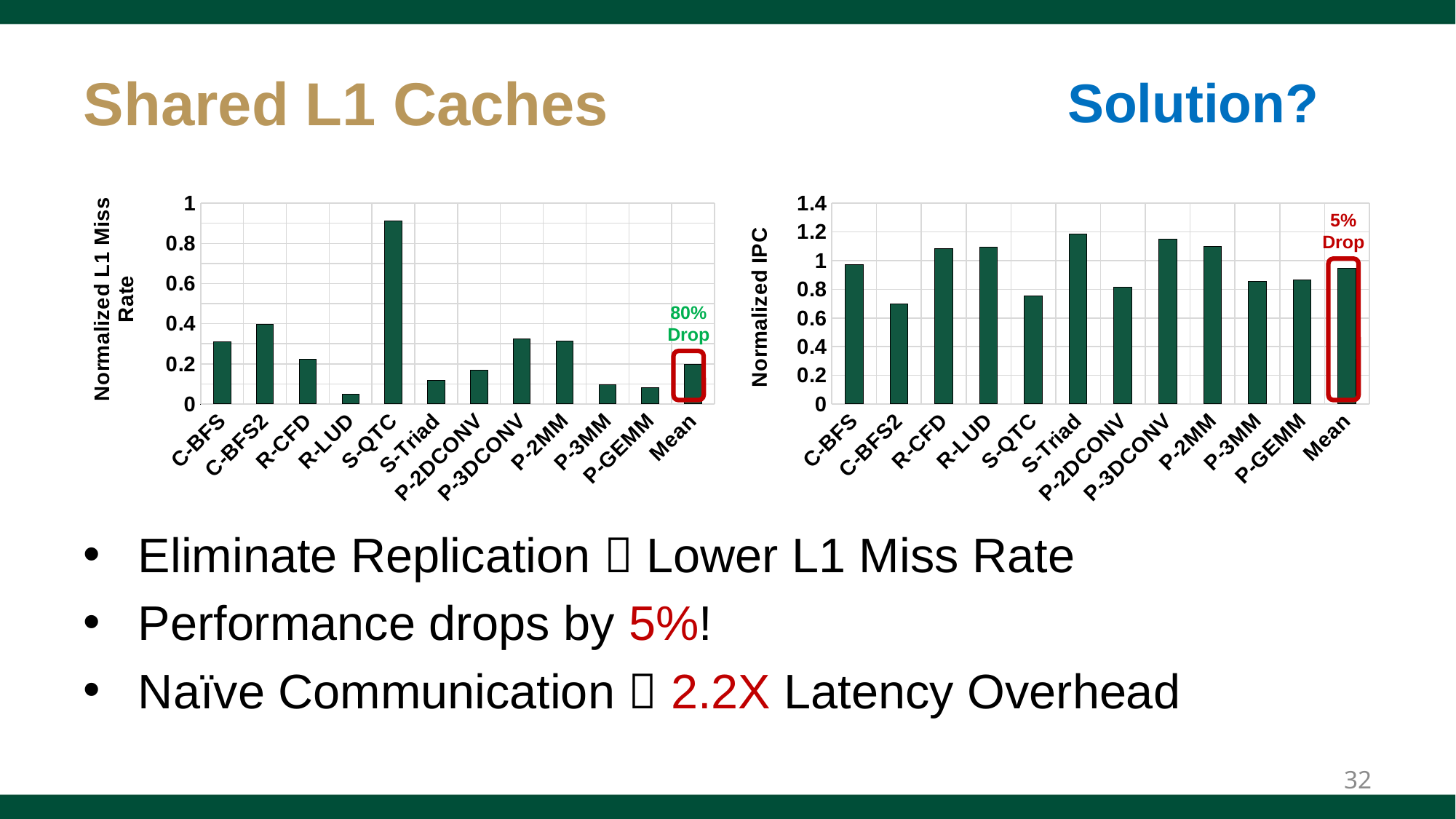
In the left chart (Normalized L1 Miss Rate), which category has the lowest value? R-LUD How many categories are shown on the x axis of the right chart (Normalized IPC)? 12 In the right chart (Normalized IPC), is the value for S-Triad greater or less than 1? greater What is the y-axis label of the right chart? Normalized IPC In the left chart (Normalized L1 Miss Rate), is the value for Mean greater or less than 0.4? less In the left chart (Normalized L1 Miss Rate), is the value for S-QTC greater or less than 0.8? greater In the left chart (Normalized L1 Miss Rate), which is larger, the value for C-BFS or the value for C-BFS2? C-BFS2 What kind of chart is the left chart (Normalized L1 Miss Rate)? bar chart In the right chart (Normalized IPC), which is larger, the value for P-2DCONV or the value for P-3DCONV? P-3DCONV What drop is annotated above the Mean bar in the left chart (Normalized L1 Miss Rate)? 80% Drop In the left chart (Normalized L1 Miss Rate), which category has the highest value? S-QTC